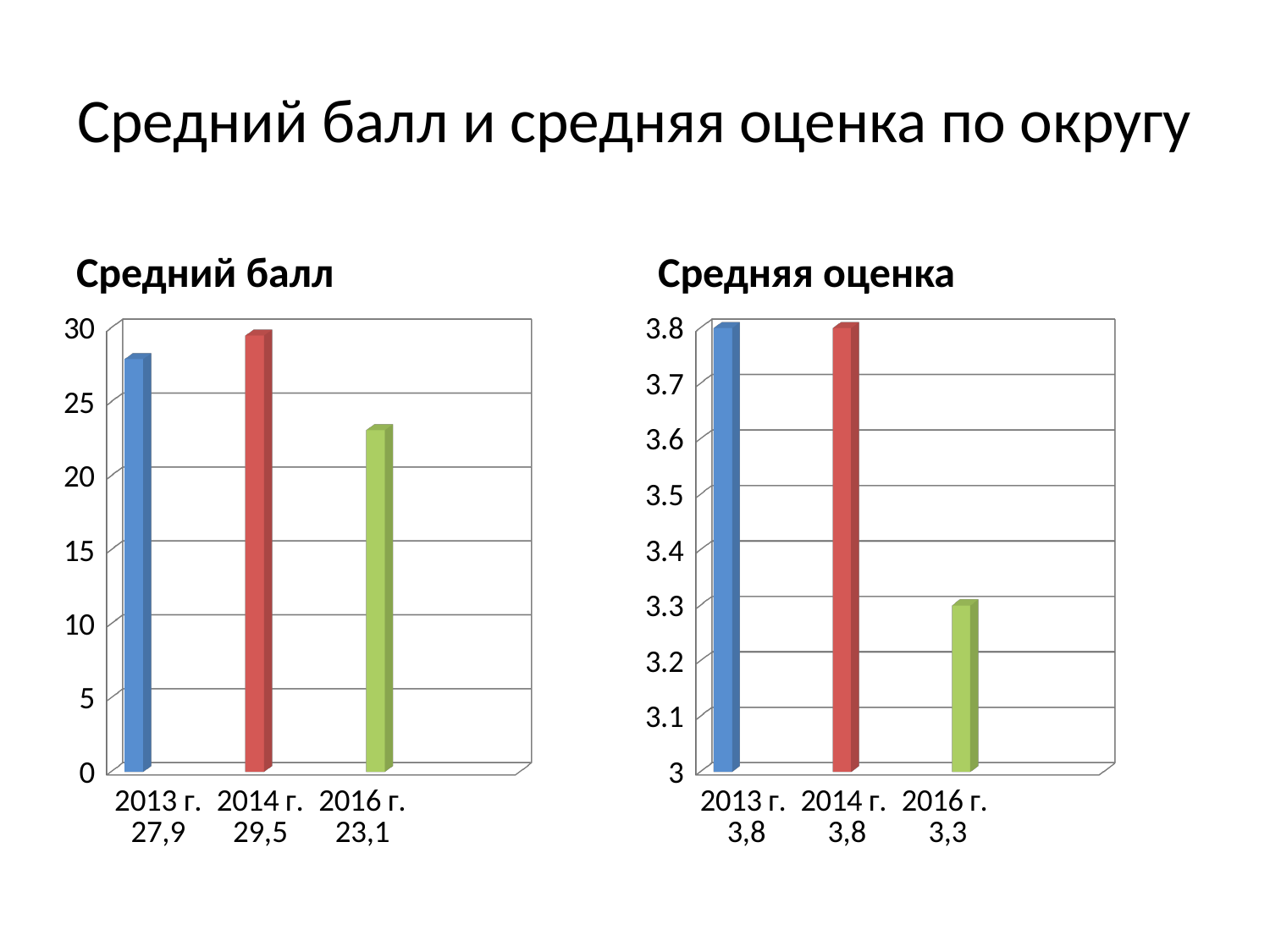
In the chart titled "Средний балл", what is the difference between the values for 2014 г. and 2013 г.? 1,6 In the chart titled "Средний балл", what is the value for 2014 г.? 29,5 In the chart titled "Средний балл", which year has the highest value? 2014 г. In the chart titled "Средний балл", which year has the lowest value? 2016 г. In the chart titled "Средняя оценка", what is the value for 2016 г.? 3,3 In the chart titled "Средняя оценка", what is the value for 2013 г.? 3,8 In the chart titled "Средняя оценка", what is the difference between the values for 2014 г. and 2016 г.? 0,5 In the chart titled "Средний балл", what is the value for 2016 г.? 23,1 How many bars are shown in the chart titled "Средняя оценка"? 3 What type of chart is the chart titled "Средний балл"? bar chart In the chart titled "Средняя оценка", which year has the lowest value? 2016 г. In the chart titled "Средний балл", is the value for 2013 г. greater or less than 25? greater